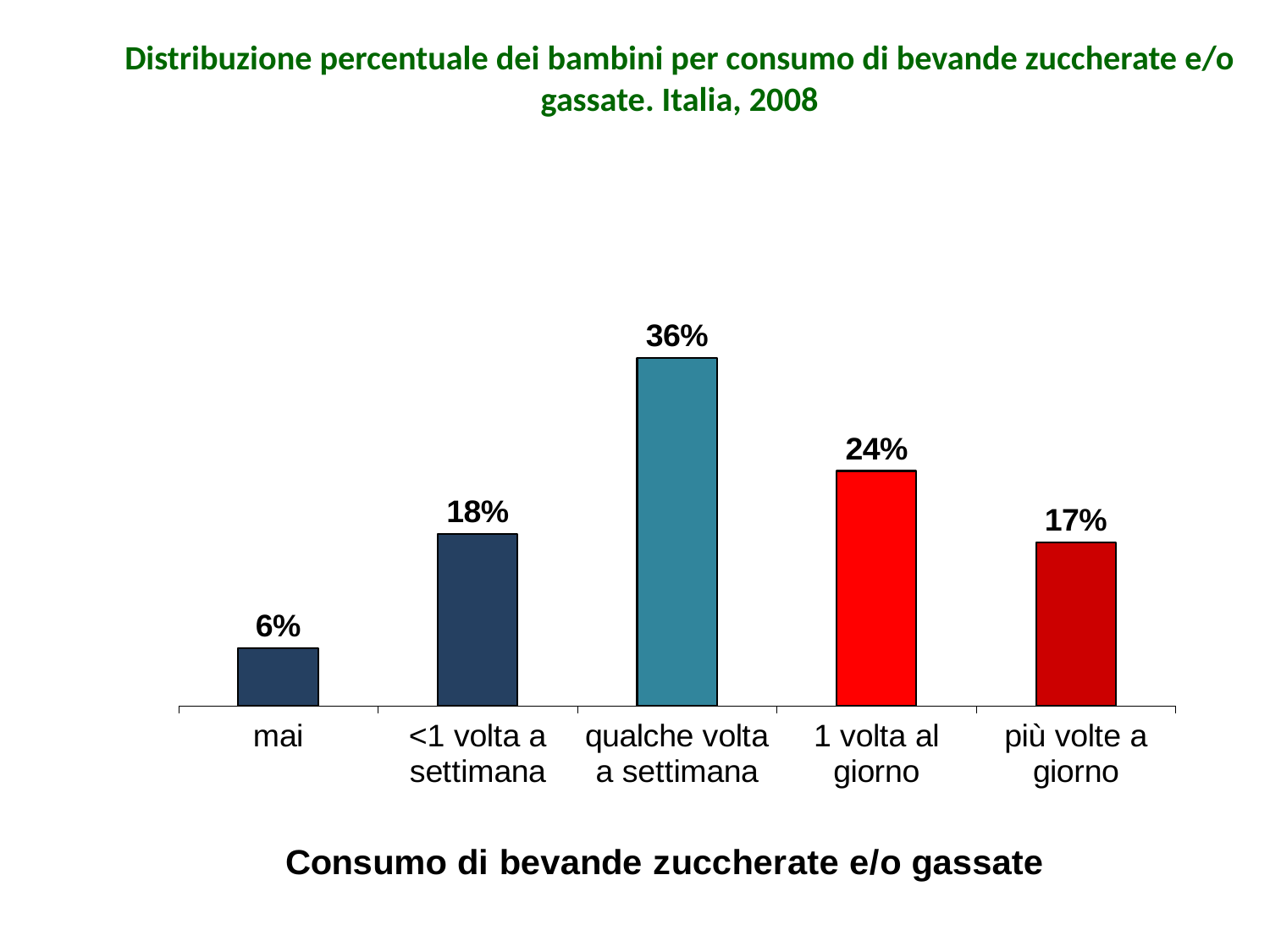
What kind of chart is shown on the slide? bar chart Which is larger, the value for '1 volta al giorno' or for 'più volte a giorno'? 1 volta al giorno What percentage of children consume sugary and/or fizzy drinks 'qualche volta a settimana'? 36% How many categories are shown on the x axis? 5 Which category has the lowest percentage? mai Which category has the highest percentage? qualche volta a settimana What percentage is shown for '1 volta al giorno'? 24% What is the value shown for the 'mai' category? 6% What is the value for 'più volte a giorno'? 17% What is the difference between the values for '<1 volta a settimana' and 'mai'? 12% What is the difference between the values for 'qualche volta a settimana' and '1 volta al giorno'? 12% What is the x-axis title of the chart? Consumo di bevande zuccherate e/o gassate